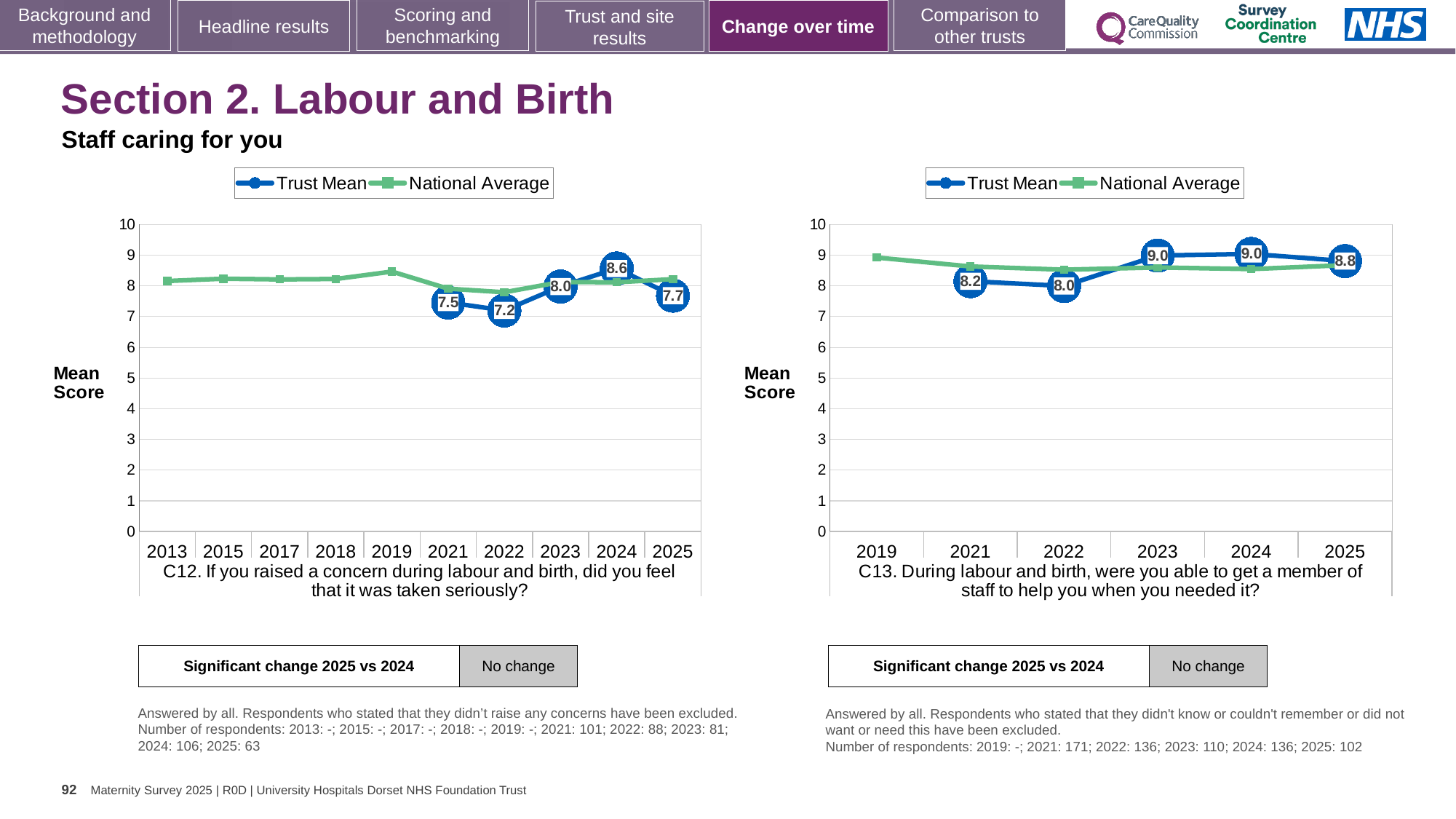
In the C13 chart, what is the Trust Mean for 2025? 8.8 How many years are shown on the x axis of the C12 chart? 10 How many series does the legend of the C13 chart list? 2 In the C12 chart, which year has the lowest Trust Mean? 2022 In the C13 chart, what is the difference between the Trust Mean in 2023 and in 2021? 0.8 In the C12 chart, what is the difference between the Trust Mean in 2024 and in 2025? 0.9 In the C12 chart, what is the Trust Mean for 2024? 8.6 In the C13 chart, is the National Average for 2019 greater or less than 8? greater In the C12 chart, which year has the highest Trust Mean? 2024 In the C12 chart, what is the Trust Mean for 2022? 7.2 In the C13 chart, is the Trust Mean higher in 2021 or in 2025? 2025 In the C13 chart, which year has the lowest Trust Mean? 2022